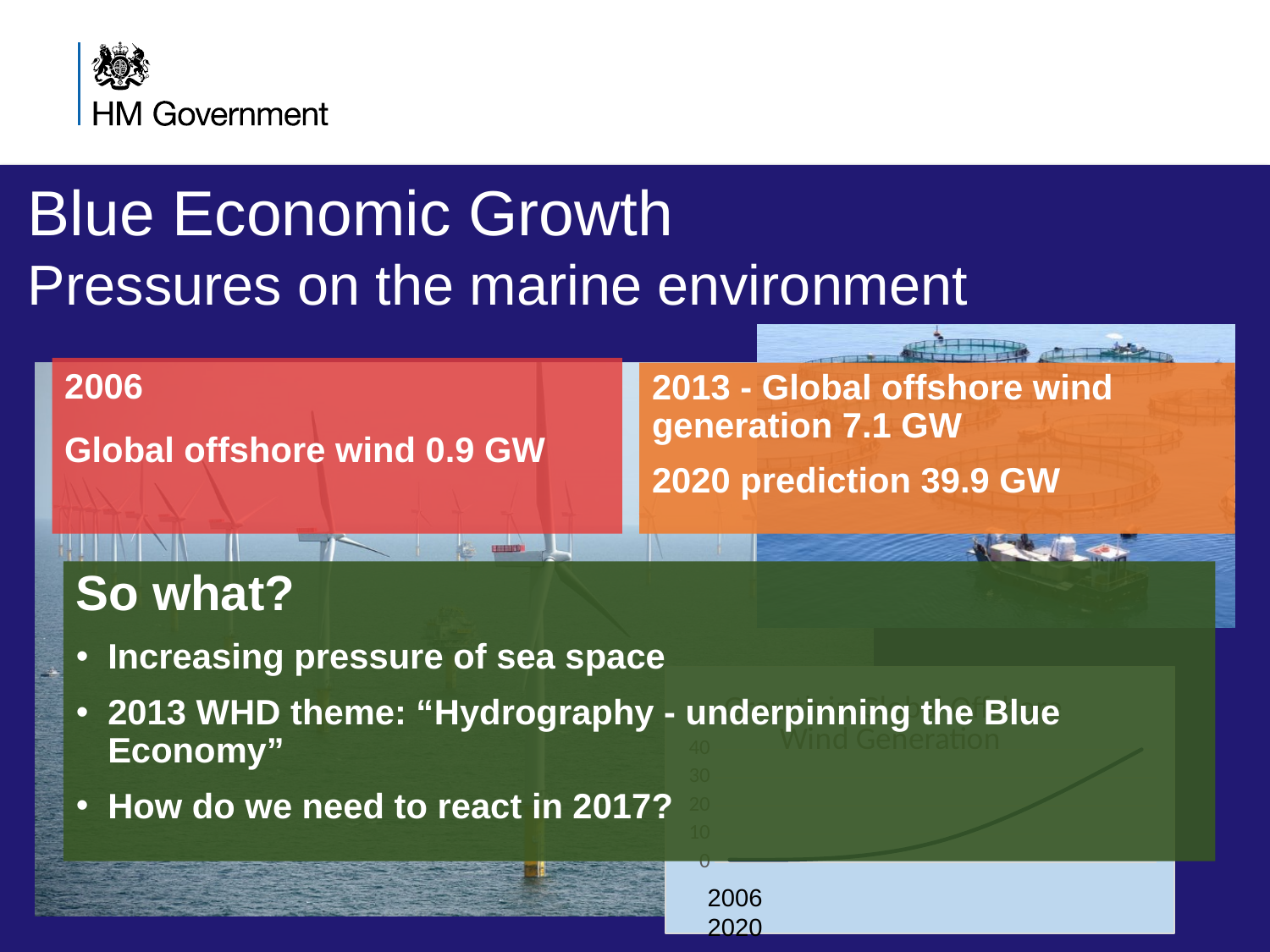
What is the highest tick value shown on the y axis of the chart at the bottom right? 40 In the chart at the bottom right, is the value for 2020 greater or less than 20? greater What kind of chart is shown at the bottom right of the slide? line chart What is the first year label shown on the x axis of the chart at the bottom right? 2006 In the chart at the bottom right, is the value for 2006 greater or less than 10? less In the chart at the bottom right, do the values rise or fall from 2006 to 2020? rise